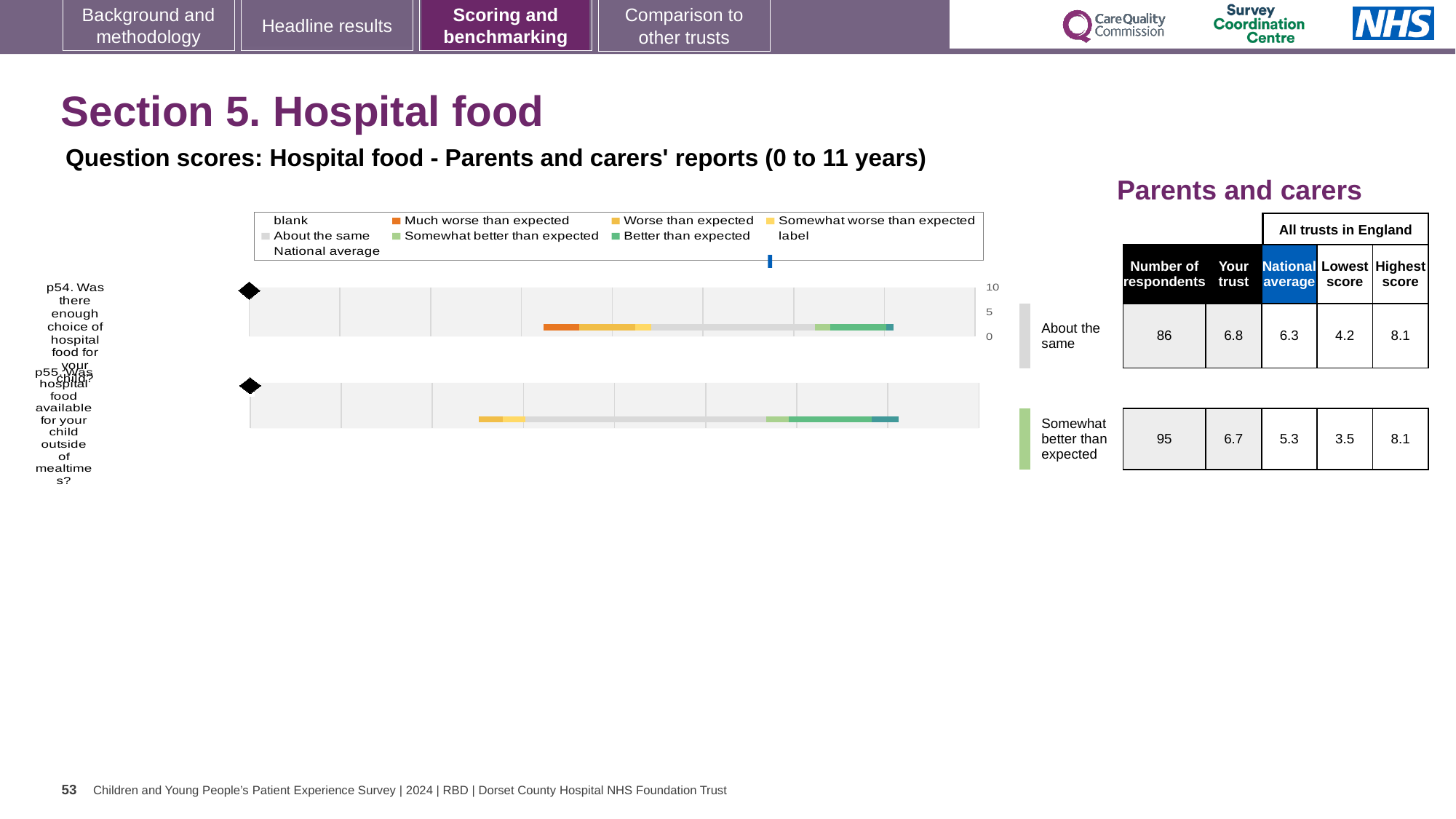
What is the 'Your trust' score for p54 (Was there enough choice of hospital food for your child?)? 6.8 How many respondents answered p55? 95 How many survey questions are plotted as bars in the hospital food chart? 2 What kind of chart is used to show the question scores for hospital food? bar chart What is the highest score across all trusts in England for p54? 8.1 What is the lowest score across all trusts in England for p55? 3.5 Which question has the higher 'Your trust' score, p54 or p55? p54 What is the 'Your trust' score for p55 (Was hospital food available for your child outside of mealtimes?)? 6.7 Which benchmark category is the trust's p54 score placed in? About the same What is the national average score for p54? 6.3 Which benchmark category is the trust's p55 score placed in? Somewhat better than expected By how much does the trust's score for p54 exceed the national average for p54? 0.5